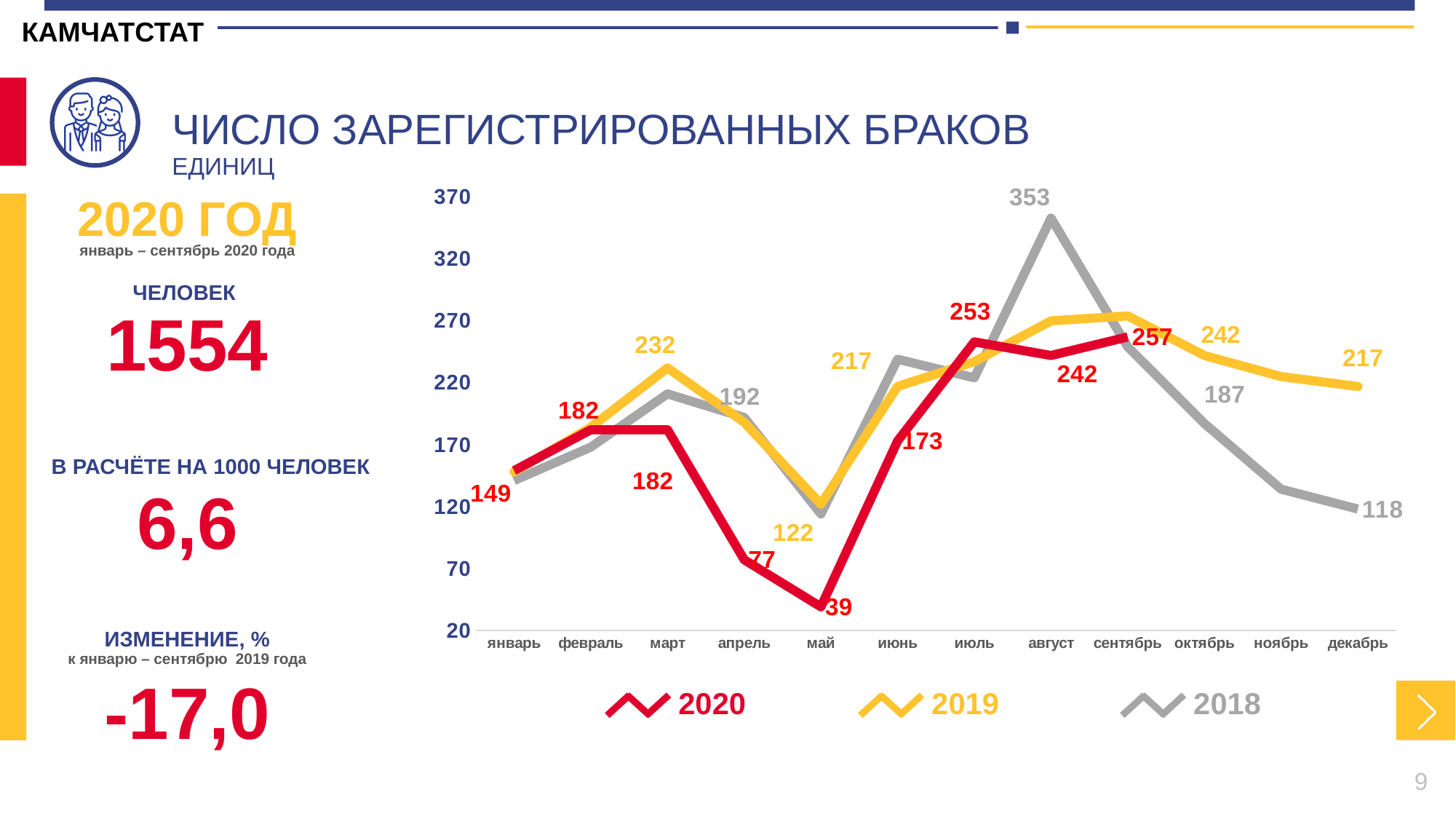
What is the value for the 2019 series in декабрь (December)? 217 Is the value for the 2018 series in ноябрь (November) greater or less than 170? less What kind of chart is shown on the slide? line chart How many series does the legend list? 3 Which is larger in март (March): the 2020 value or the 2019 value? 2019 What is the value for the 2020 series in май (May)? 39 In which month does the 2020 series reach its highest value? сентябрь What is the difference between the 2020 values for июль (July) and август (August)? 11 How many months are shown on the x axis? 12 What is the value for the 2018 series in август (August)? 353 In which month does the 2020 series reach its lowest value? май What is the value for the 2020 series in сентябрь (September)? 257